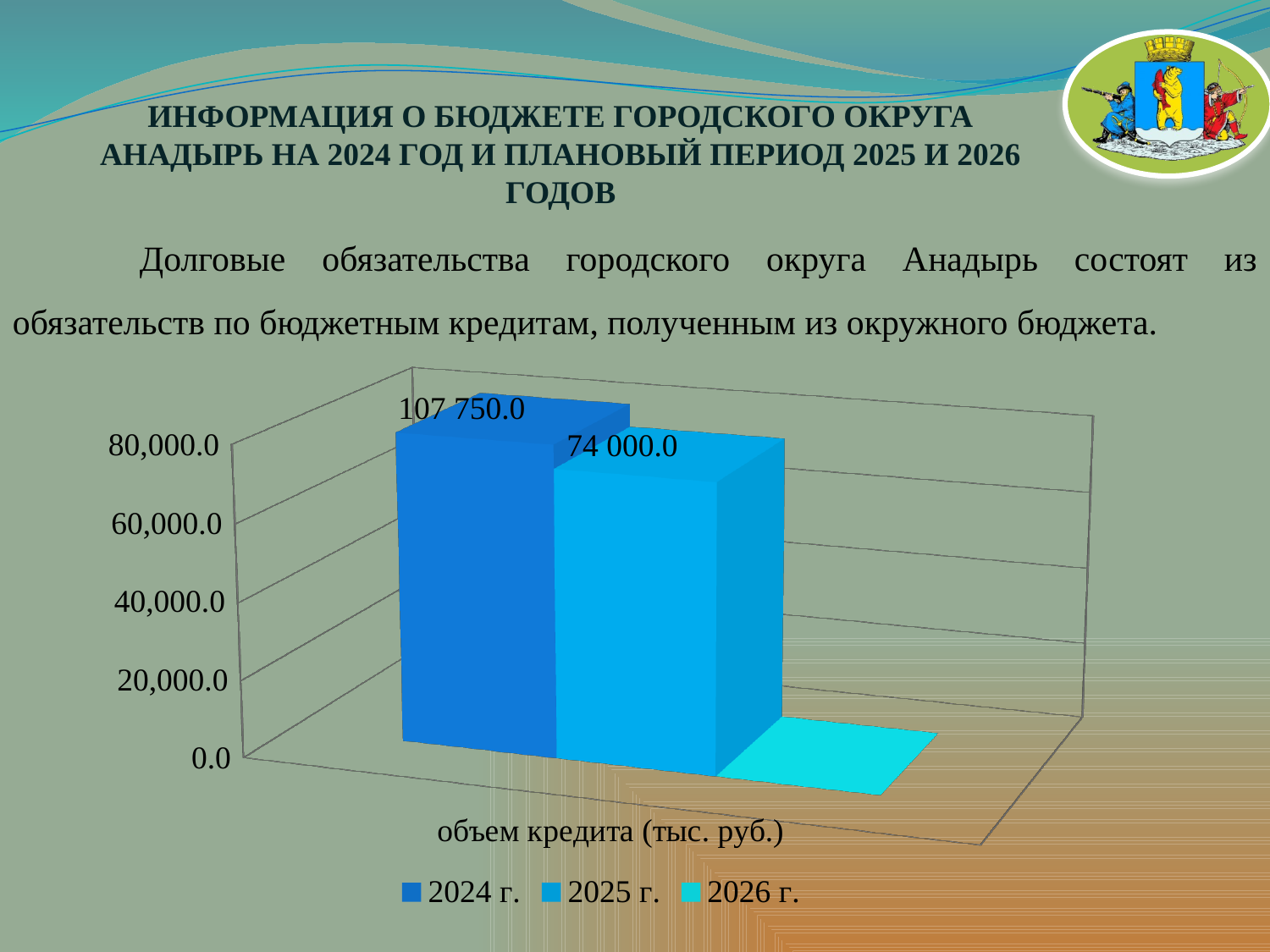
What is the label of the category on the x axis of the chart? объем кредита (тыс. руб.) What is the value for the 2025 г. series in the chart? 74 000.0 How many categories are shown on the x axis of the chart? 1 What is the difference between the 2024 г. value and the 2025 г. value? 33 750.0 What kind of chart is shown on the slide? bar chart Which series has the highest value in the chart? 2024 г. Is the value for 2025 г. greater or less than 60,000.0? greater What is the value for the 2024 г. series in the chart? 107 750.0 Which is larger, the value for 2024 г. or the value for 2025 г.? 2024 г. Is the value for 2026 г. greater or less than 20,000.0? less How many series does the legend list? 3 Which series has the lowest value in the chart? 2026 г.